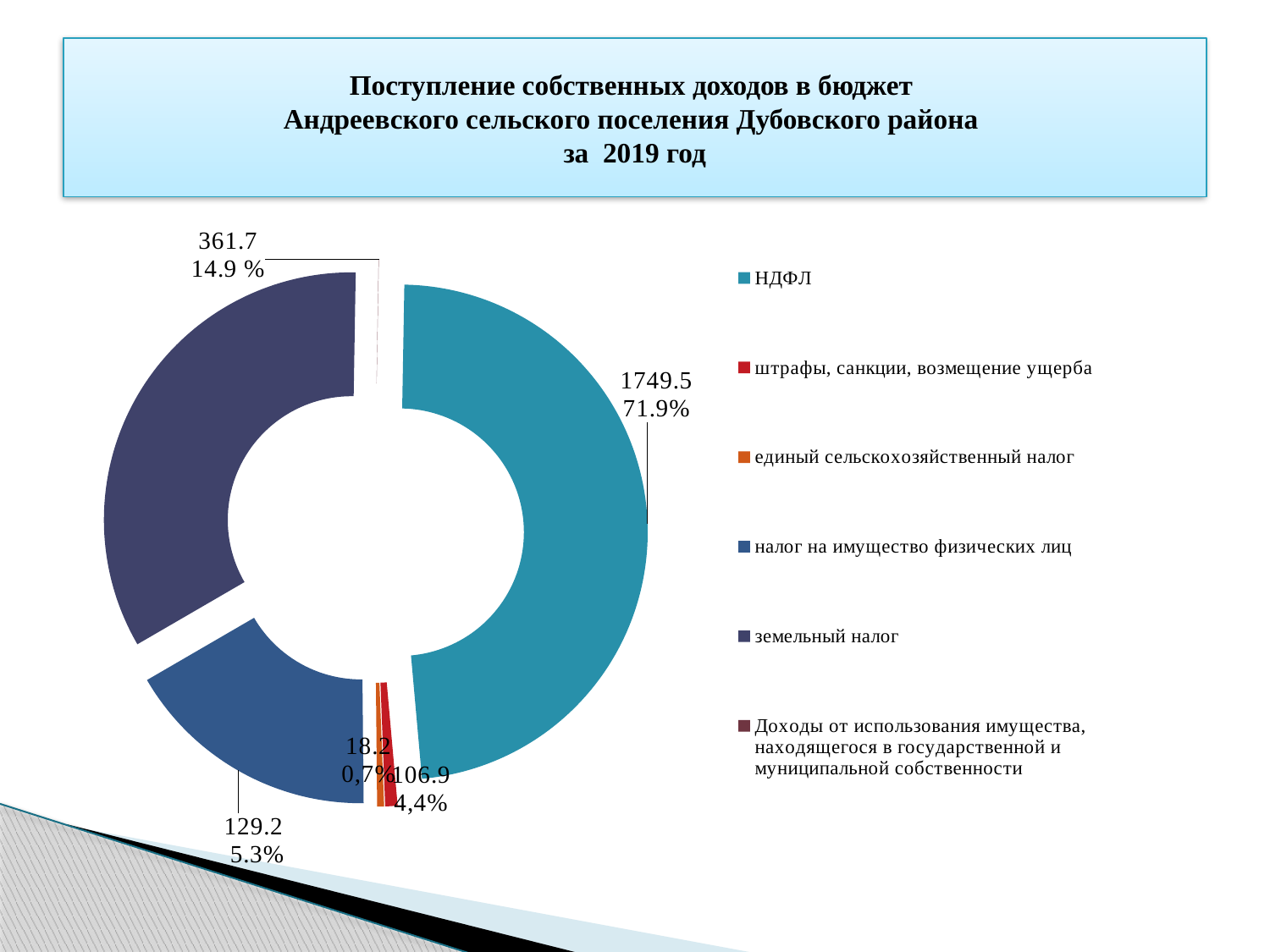
What is the value shown for НДФЛ? 1749.5 What is the value shown for налог на имущество физических лиц? 129.2 Which year does the chart title refer to? 2019 Which category has the largest slice? НДФЛ What is the value shown for земельный налог? 361.7 How many categories does the legend list? 6 What share of the total does налог на имущество физических лиц account for? 5.3% What share of the total does НДФЛ account for? 71.9% What is the difference between the values for НДФЛ and земельный налог? 1387.8 What kind of chart is shown on the slide? doughnut (pie) chart Which is larger: земельный налог or налог на имущество физических лиц? земельный налог What share of the total does земельный налог account for? 14.9 %